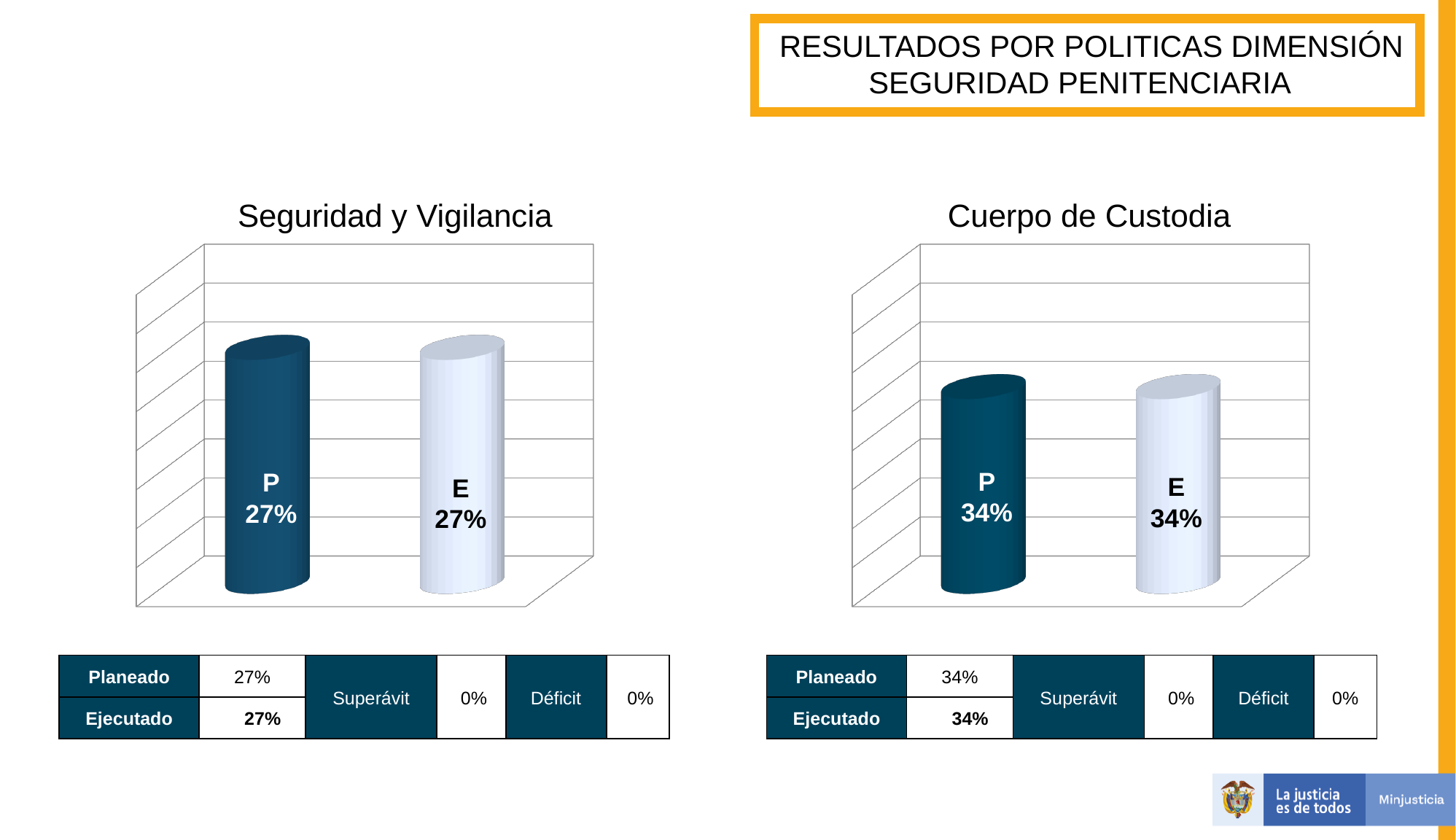
What kind of chart is the 'Cuerpo de Custodia' chart? Bar chart In the 'Cuerpo de Custodia' chart, what is the difference between the P and E values? 0% In the 'Cuerpo de Custodia' chart, what is the value of the P bar? 34% What is the title of the chart on the right side of the slide? Cuerpo de Custodia In the 'Seguridad y Vigilancia' chart, what is the value of the E bar? 27% In the 'Seguridad y Vigilancia' chart, what is the difference between the P and E values? 0% How many bars are plotted in the 'Cuerpo de Custodia' chart? 2 How many bars are plotted in the 'Seguridad y Vigilancia' chart? 2 Is the P value in the 'Cuerpo de Custodia' chart larger than the P value in the 'Seguridad y Vigilancia' chart? Yes What is the title of the chart on the left side of the slide? Seguridad y Vigilancia In the 'Seguridad y Vigilancia' chart, what is the value of the P bar? 27% In the 'Cuerpo de Custodia' chart, what is the value of the E bar? 34%